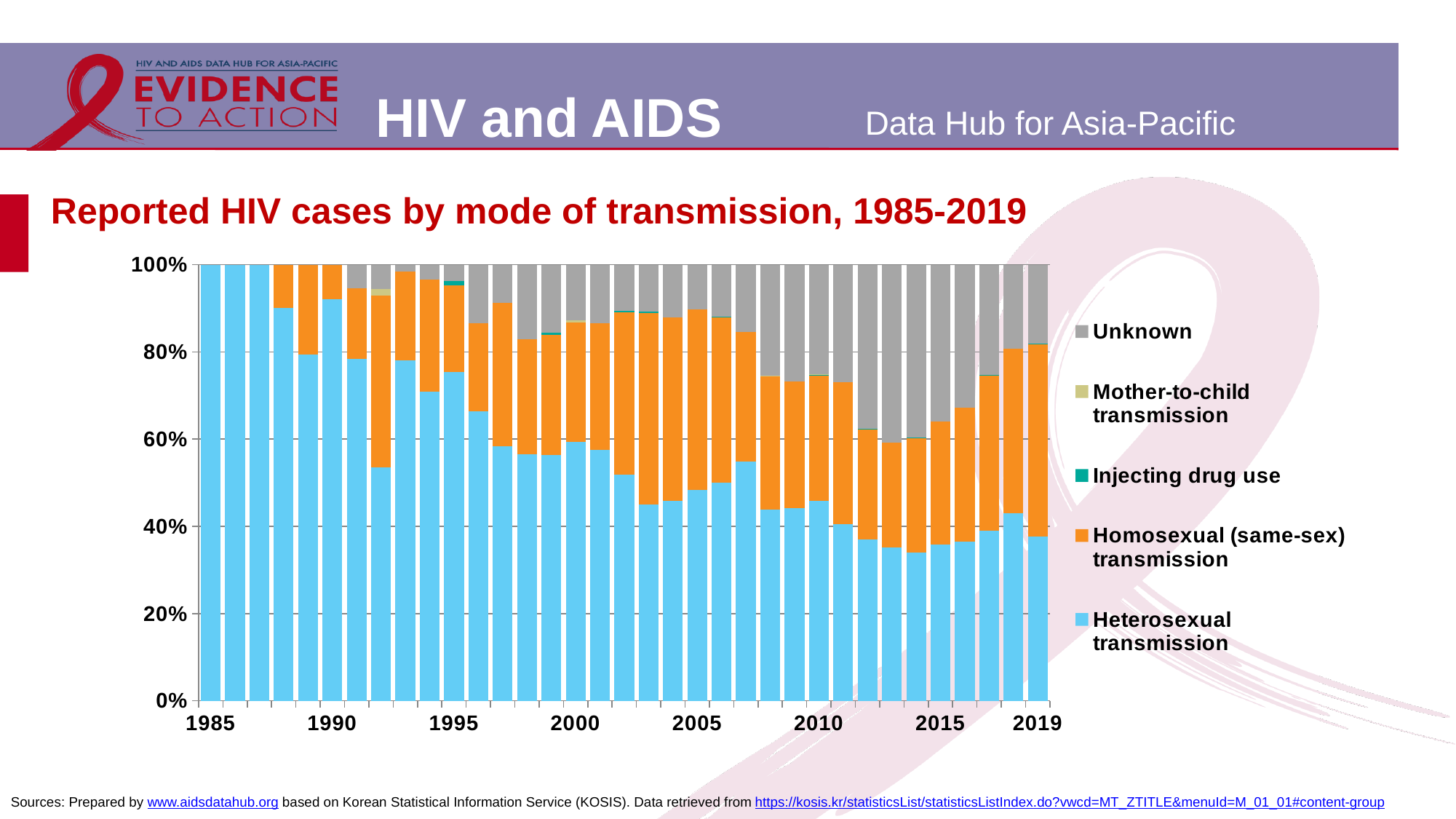
Is the share of heterosexual transmission in 1990 greater or less than 80%? greater How many years (bars) are plotted on the chart? 35 Is the share of heterosexual transmission in 2013 greater or less than 40%? less What kind of chart is shown on the slide? Stacked bar chart Which is larger in 2019: the share of heterosexual transmission or the share of homosexual (same-sex) transmission? Homosexual (same-sex) transmission What is the share of heterosexual transmission in 1985? 100% Is the share of heterosexual transmission in 1995 greater or less than 60%? greater Does the share of heterosexual transmission generally rise or fall from 1985 to 2019? fall What is the title of the chart? Reported HIV cases by mode of transmission, 1985-2019 How many series does the legend list? 5 Which colour represents the Unknown category in the legend? Grey